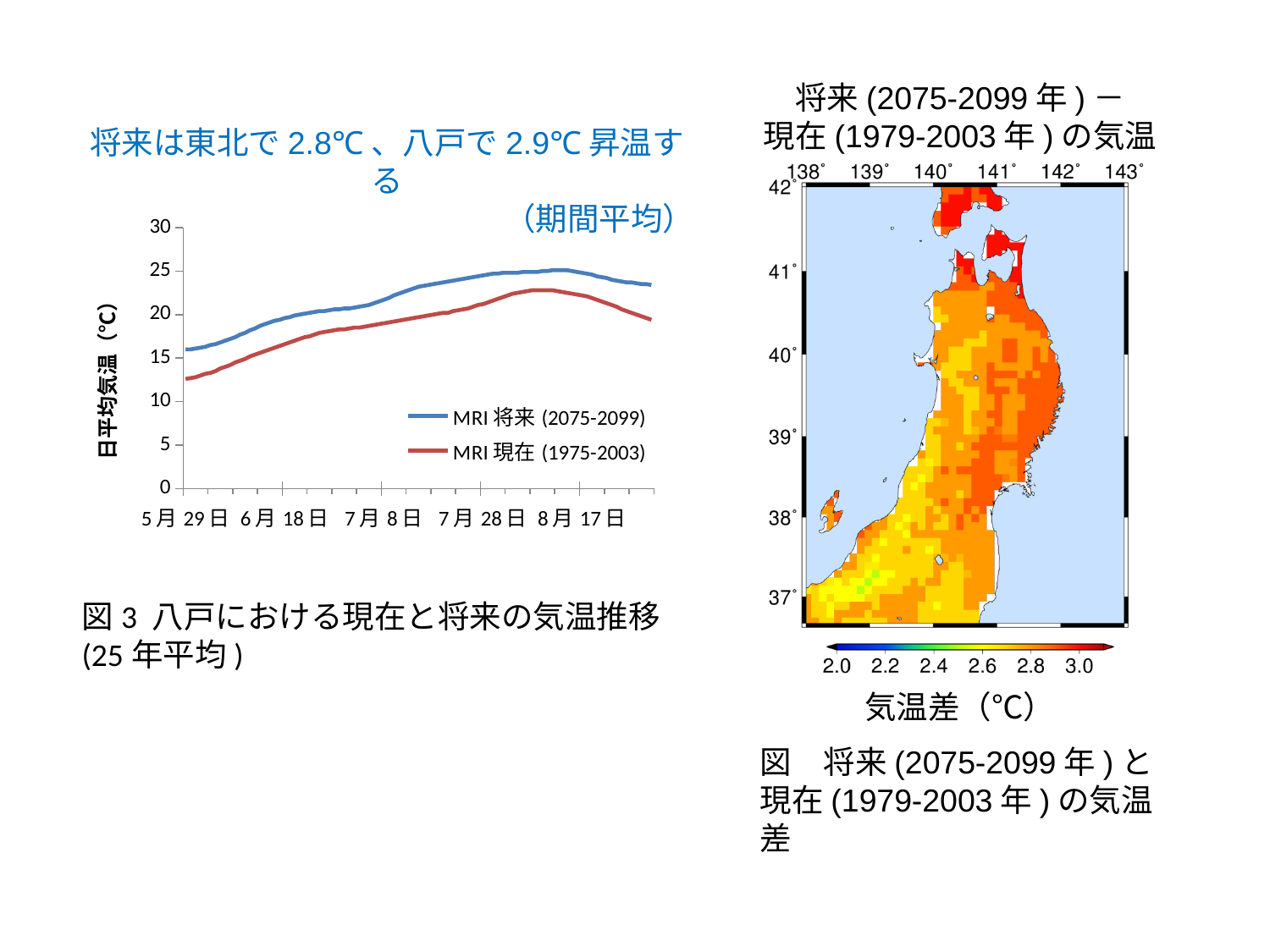
How many date labels are shown on the x axis of the left line chart? 5 How many series does the legend of the left line chart list? 2 In the left line chart, is the peak value of MRI 現在 (1975-2003) greater or less than 20? greater In the left line chart, which series is higher throughout the period, MRI 将来 (2075-2099) or MRI 現在 (1975-2003)? MRI 将来 (2075-2099) What is the label of the y axis of the left line chart? 日平均気温 (℃) In the left line chart, is the value for MRI 将来 (2075-2099) at 5月29日 greater or less than 20? less In the left line chart, which series is plotted in blue? MRI 将来 (2075-2099) In the left line chart, is the value for MRI 現在 (1975-2003) at 5月29日 greater or less than 15? less In the left line chart, does the MRI 将来 (2075-2099) series rise or fall from 5月29日 to 7月28日? rise What kind of chart is the chart on the left of the slide (図3)? line chart